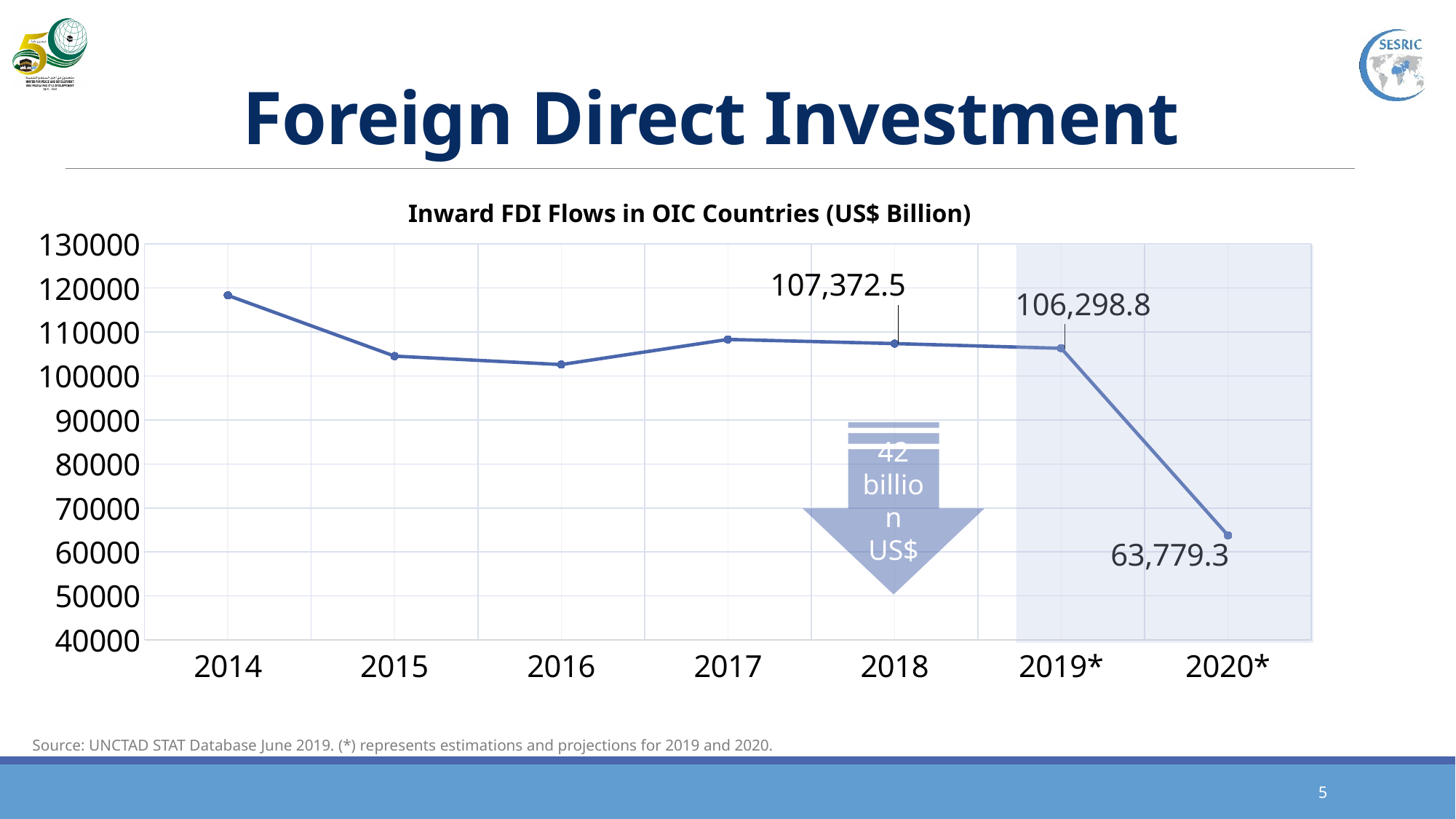
What is the value for 2018 in the Inward FDI Flows chart? 107,372.5 What is the value for 2019* in the Inward FDI Flows chart? 106,298.8 Is the value for 2014 greater or less than 110000? greater Which year has the highest value in the chart? 2014 What is the difference between the values for 2018 and 2019*? 1,073.7 Which year has the lowest value in the chart? 2020* What is the value for 2020* in the Inward FDI Flows chart? 63,779.3 Is the value for 2016 greater or less than 110000? less What is the title of the chart? Inward FDI Flows in OIC Countries (US$ Billion) What is the difference between the values for 2019* and 2020*? 42,519.5 What kind of chart is shown on the slide? line chart How many years are plotted on the x axis? 7